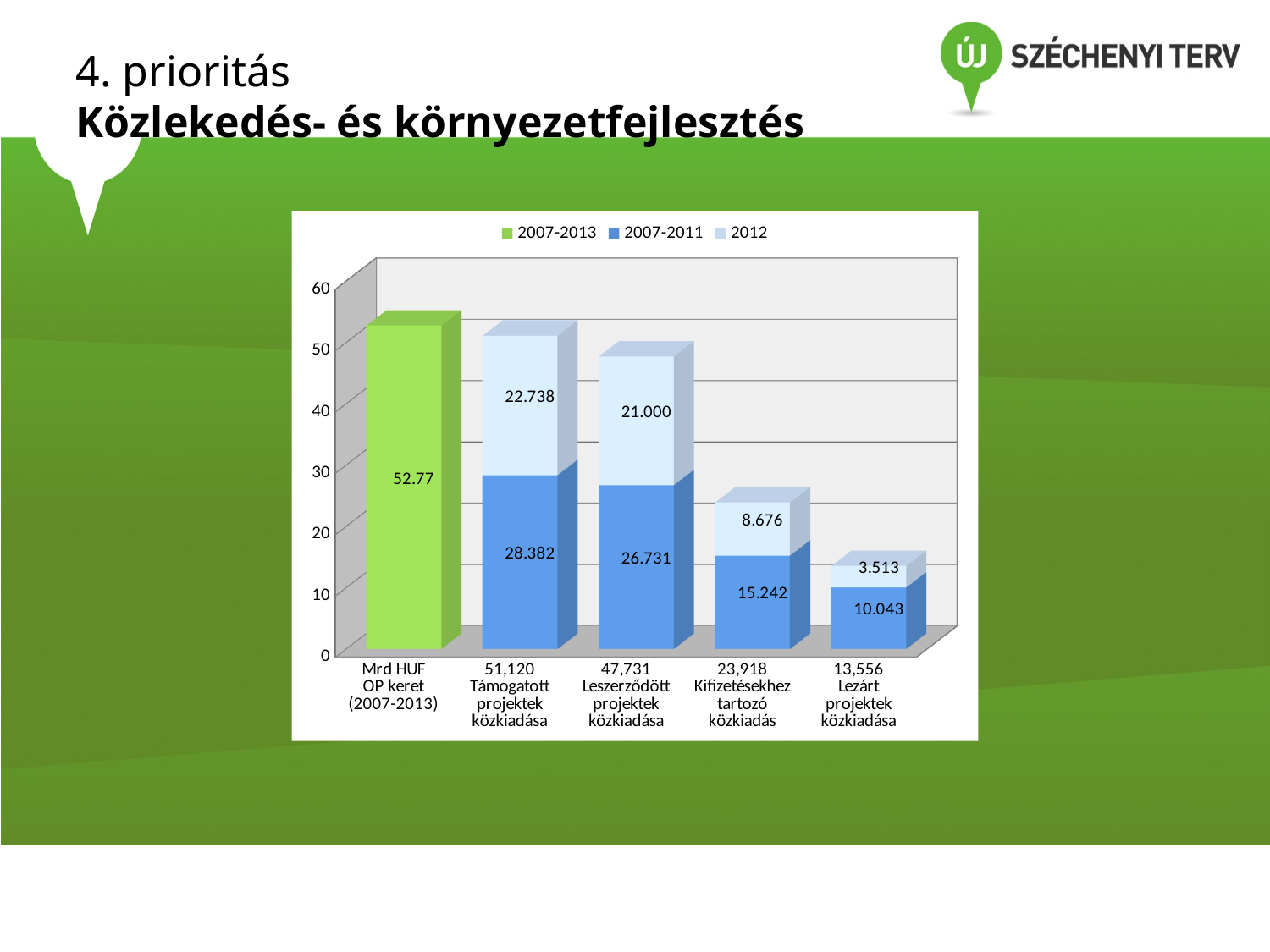
What is the 2007-2011 value for Támogatott projektek közkiadása? 28.382 How many series does the legend list? 3 Which category has the lowest 2007-2011 value? Lezárt projektek közkiadása What kind of chart is shown on the slide? Stacked bar chart What is the 2012 value for Lezárt projektek közkiadása? 3.513 How many categories are shown on the x axis? 5 What is the value of the Mrd HUF OP keret (2007-2013) bar? 52.77 What is the total of the stacked bar for Kifizetésekhez tartozó közkiadás? 23.918 Which category has the highest 2012 value? Támogatott projektek közkiadása What is the difference between the 2007-2011 values for Kifizetésekhez tartozó közkiadás and Lezárt projektek közkiadása? 5.199 Which is larger: the 2012 value for Támogatott projektek közkiadása or the 2012 value for Leszerződött projektek közkiadása? Támogatott projektek közkiadása What is the 2012 value for Leszerződött projektek közkiadása? 21.000